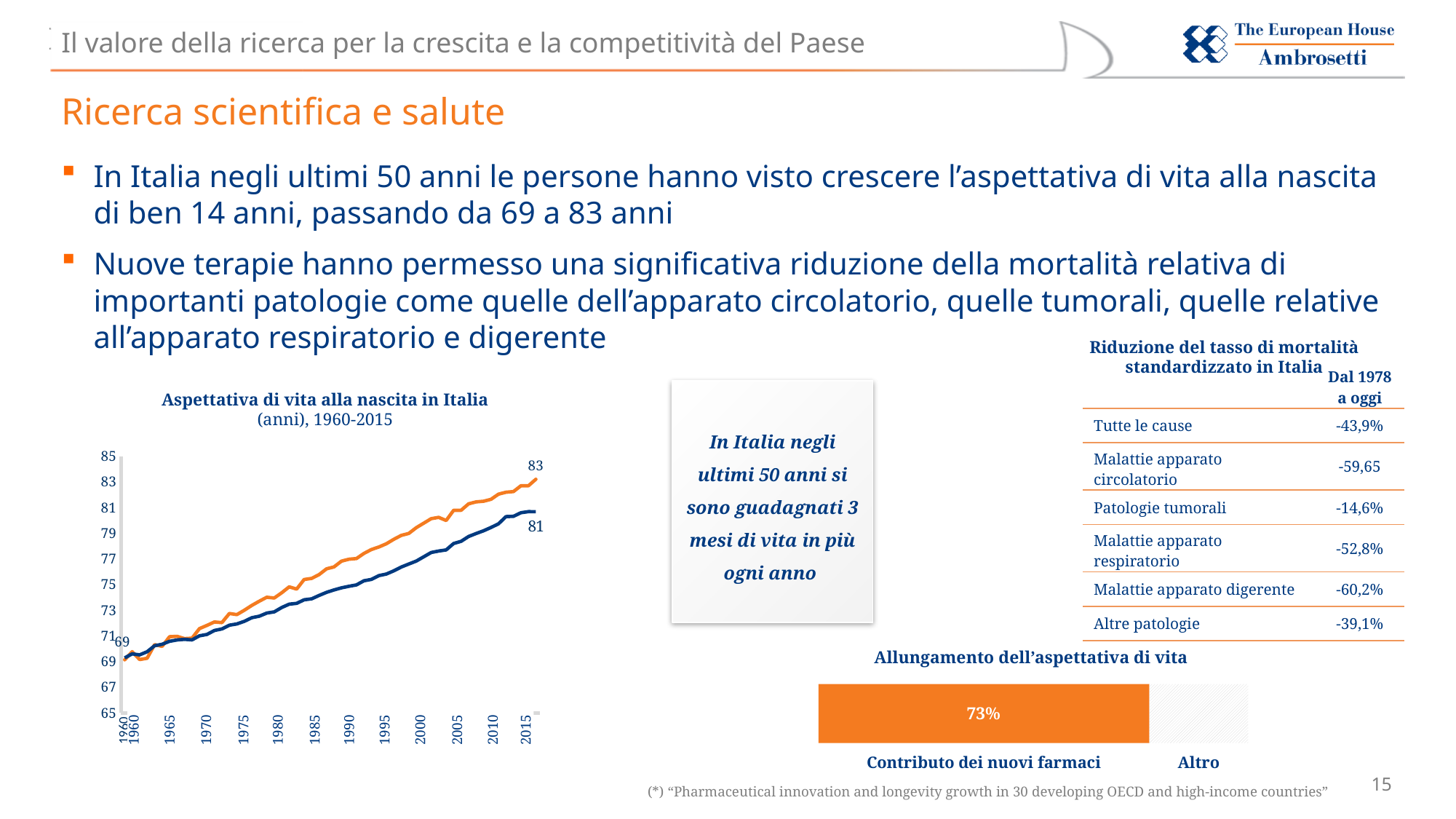
How many lines are plotted in the chart 'Aspettativa di vita alla nascita in Italia'? 2 In the chart 'Aspettativa di vita alla nascita in Italia', is the value of the blue line in 1970 greater or less than 75? less In the chart 'Allungamento dell'aspettativa di vita', what percentage is shown for 'Contributo dei nuovi farmaci'? 73% In the chart 'Aspettativa di vita alla nascita in Italia', which line has the higher value in 2015, the orange or the blue? Orange In the chart 'Aspettativa di vita alla nascita in Italia', what value is labelled at the start of the lines in 1960? 69 In the chart 'Aspettativa di vita alla nascita in Italia', do the values rise or fall from 1960 to 2015? Rise What kind of chart is 'Aspettativa di vita alla nascita in Italia (anni), 1960-2015'? Line chart In the chart 'Aspettativa di vita alla nascita in Italia', what is the difference between the labelled 2015 values of the orange line and the blue line? 2 What kind of chart is 'Allungamento dell'aspettativa di vita'? Bar chart In the chart 'Aspettativa di vita alla nascita in Italia', is the value of the orange line in 2010 greater or less than 81? greater In the chart 'Aspettativa di vita alla nascita in Italia', what value is labelled at the end of the blue line in 2015? 81 In the chart 'Aspettativa di vita alla nascita in Italia', what value is labelled at the end of the orange line in 2015? 83